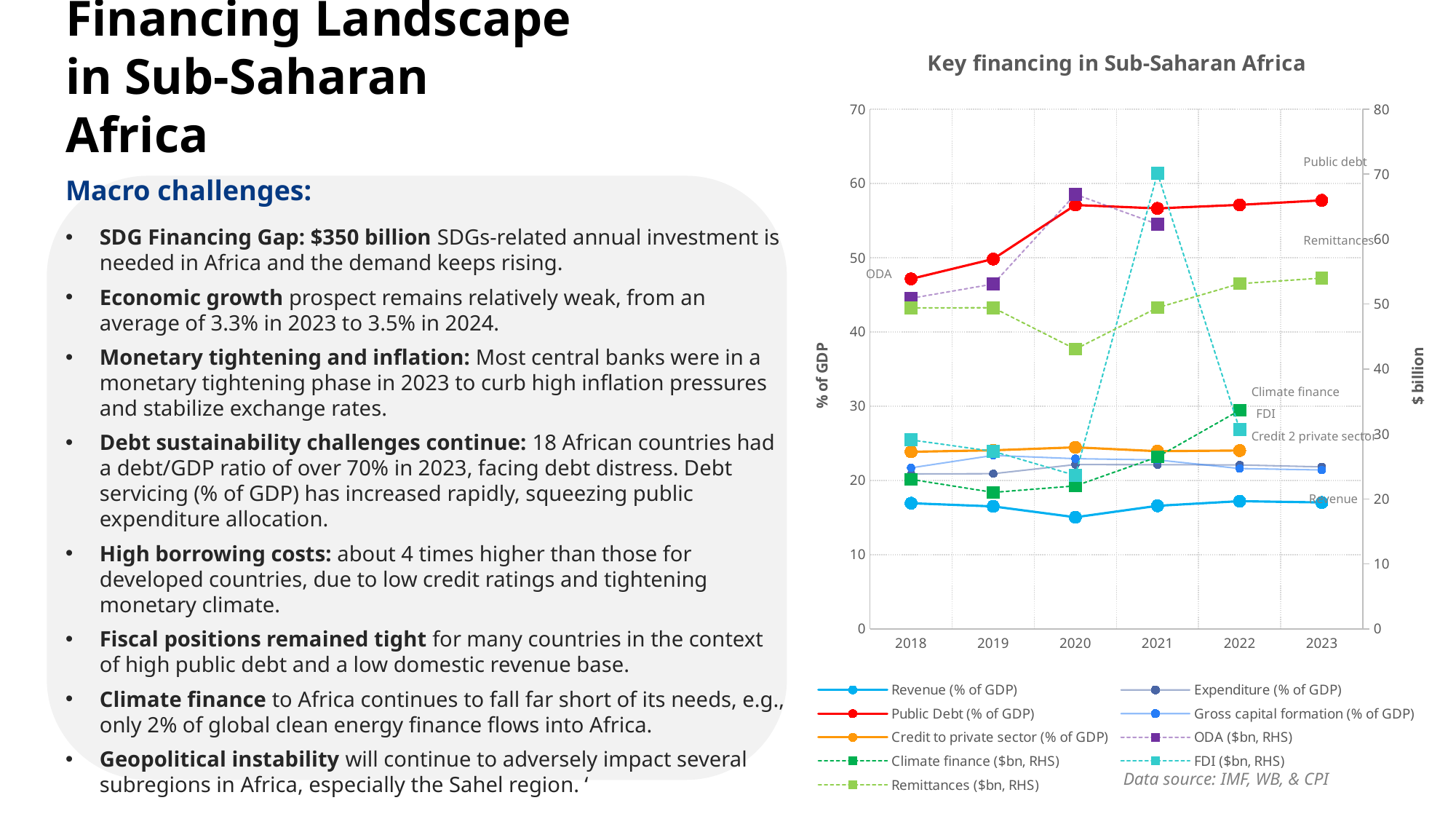
How many years are shown on the x axis of the chart? 6 What is the title of the chart? Key financing in Sub-Saharan Africa In which year is Remittances ($bn, RHS) lowest? 2020 Is the value for Public Debt (% of GDP) in 2023 greater or less than 50? greater Is the value for Revenue (% of GDP) in 2020 greater or less than 20? less In which year is FDI ($bn, RHS) highest? 2021 Is the value for Public Debt (% of GDP) in 2018 greater or less than 50? less Does Public Debt (% of GDP) rise or fall from 2018 to 2023? rise What kind of chart is shown on the slide? line chart How many series does the chart legend list? 9